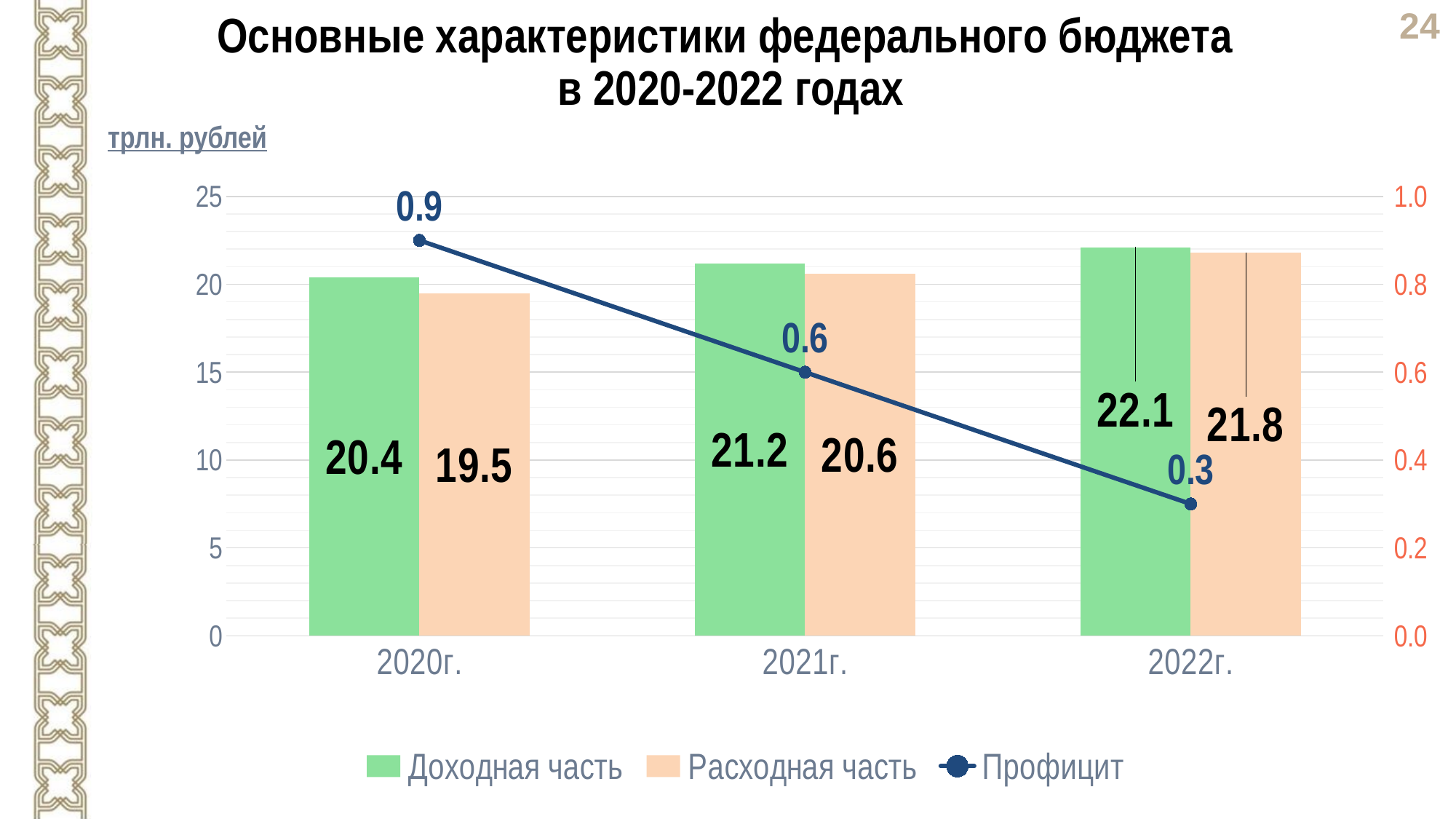
In which year is Профицит lowest? 2022г. Which is larger in 2020г., Доходная часть or Расходная часть? Доходная часть What is the difference between Доходная часть and Расходная часть in 2022г.? 0.3 What is the value of Доходная часть for 2020г.? 20.4 Does Профицит rise or fall from 2020г. to 2022г.? fall In which year is Доходная часть highest? 2022г. How many years are shown on the x axis? 3 What is the value of Расходная часть for 2021г.? 20.6 What is the value of Профицит for 2022г.? 0.3 How many series does the legend list? 3 What kind of chart is this? Combined bar and line chart What unit is stated above the chart? трлн. рублей